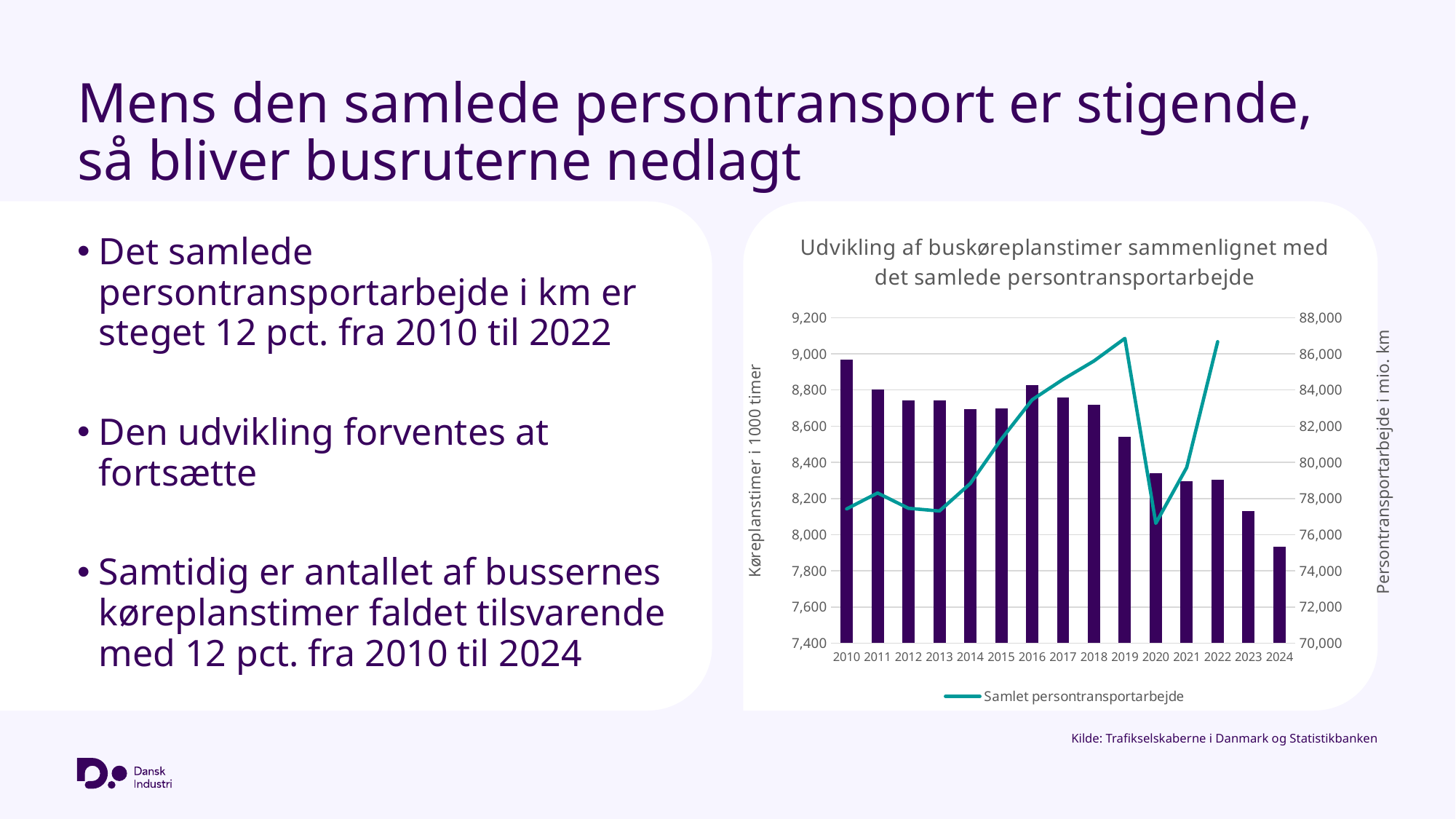
Is the Samlet persontransportarbejde line value for 2020 greater or less than 78,000? less How many series does the chart's legend list? 1 What is the title of the chart? Udvikling af buskøreplanstimer sammenlignet med det samlede persontransportarbejde Which year has the shortest bar for køreplanstimer? 2024 What is the series name shown in the chart's legend? Samlet persontransportarbejde What kind of chart is shown on the slide? A combined bar and line chart How many years are shown on the x axis of the chart? 15 Do the bars for køreplanstimer generally rise or fall from 2010 to 2024? fall Which year has the tallest bar for køreplanstimer? 2010 Is the bar value for 2024 greater or less than 8,000? less Which year has the taller bar, 2023 or 2024? 2023 Is the bar value for 2010 greater or less than 8,800? greater